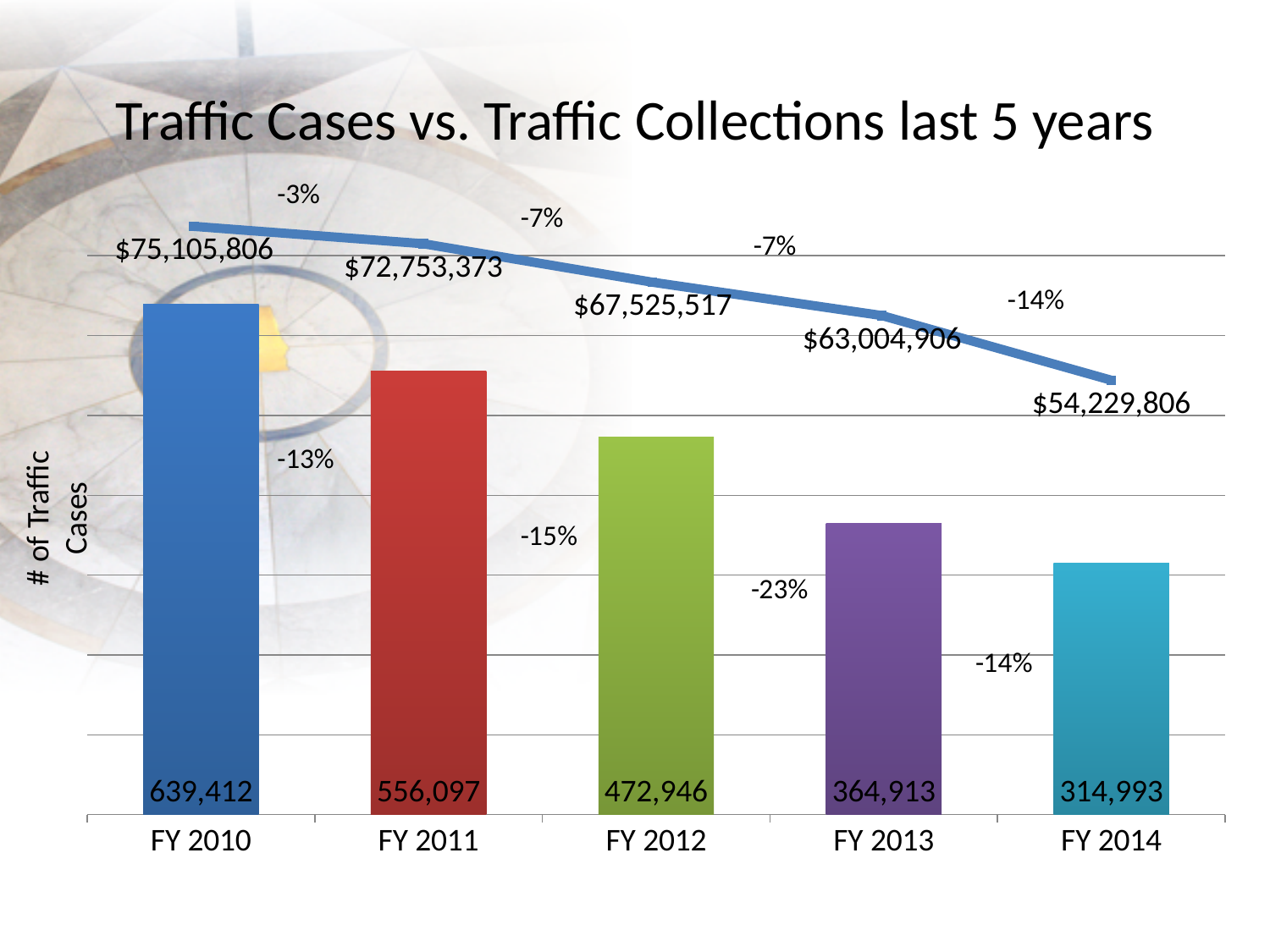
What is the difference in traffic collections between FY 2010 and FY 2014? $20,876,000 How many fiscal years are shown on the x axis? 5 Which fiscal year has the highest number of traffic cases? FY 2010 What is the traffic collections value for FY 2014? $54,229,806 Do the number of traffic cases rise or fall from FY 2010 to FY 2014? Fall What is the traffic collections value for FY 2012? $67,525,517 What is the number of traffic cases for FY 2010? 639,412 Which fiscal year has the lowest traffic collections value? FY 2014 What is the difference in the number of traffic cases between FY 2010 and FY 2011? 83,315 What is the number of traffic cases for FY 2013? 364,913 Which has more traffic cases, FY 2012 or FY 2014? FY 2012 What is the title of the chart? Traffic Cases vs. Traffic Collections last 5 years